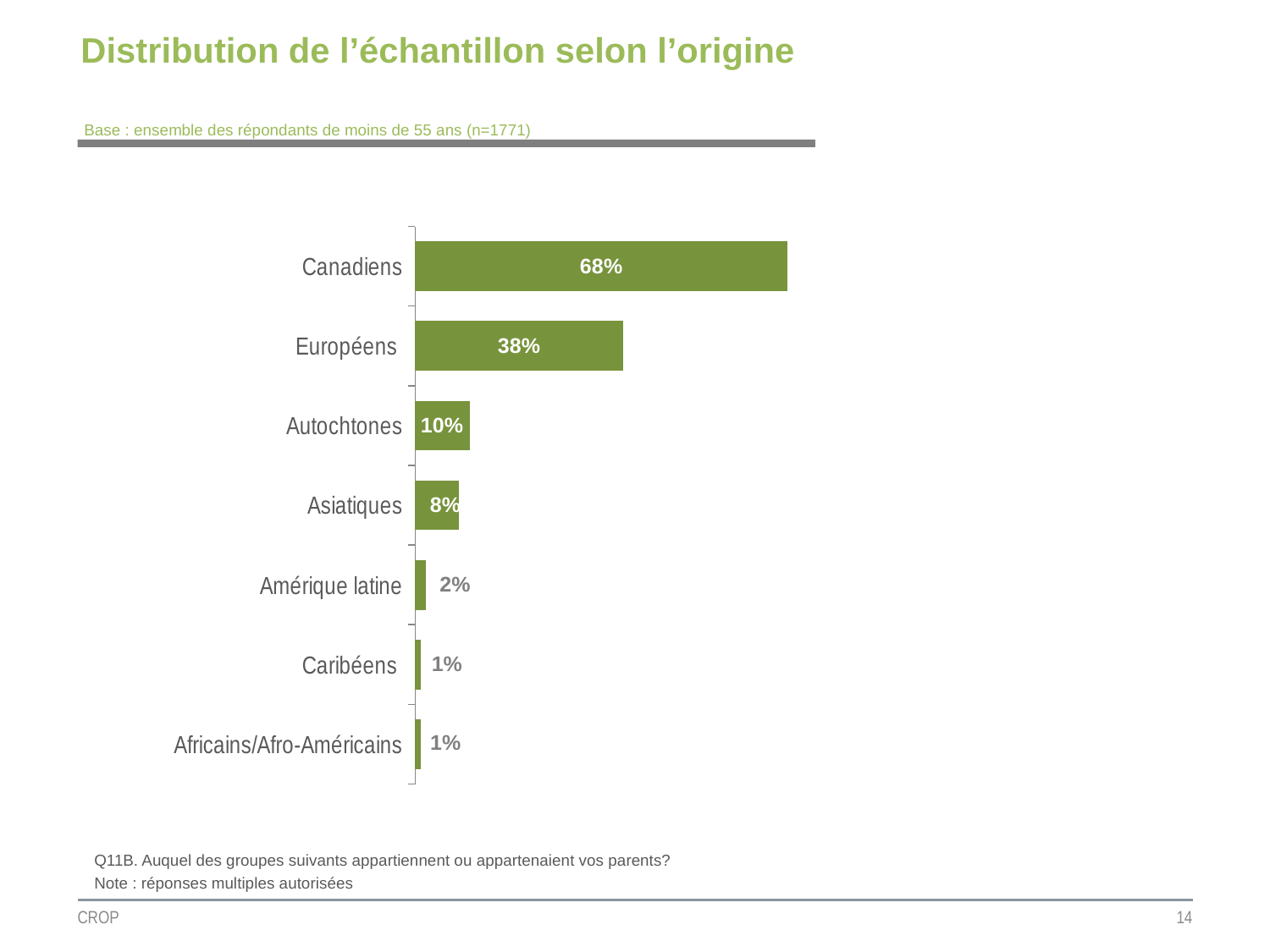
Which is larger, the value for Asiatiques or the value for Amérique latine? Asiatiques What kind of chart is shown on the slide? Bar chart What is the difference between the values for Autochtones and Asiatiques? 2% What is the value for Canadiens? 68% How many categories are shown in the chart? 7 What is the value for Européens? 38% What is the value for Autochtones? 10% What is the value for Amérique latine? 2% What is the title of the slide? Distribution de l’échantillon selon l’origine Which category has the highest value? Canadiens What is the difference between the values for Canadiens and Européens? 30% What is the sample size (n) stated in the base line? 1771